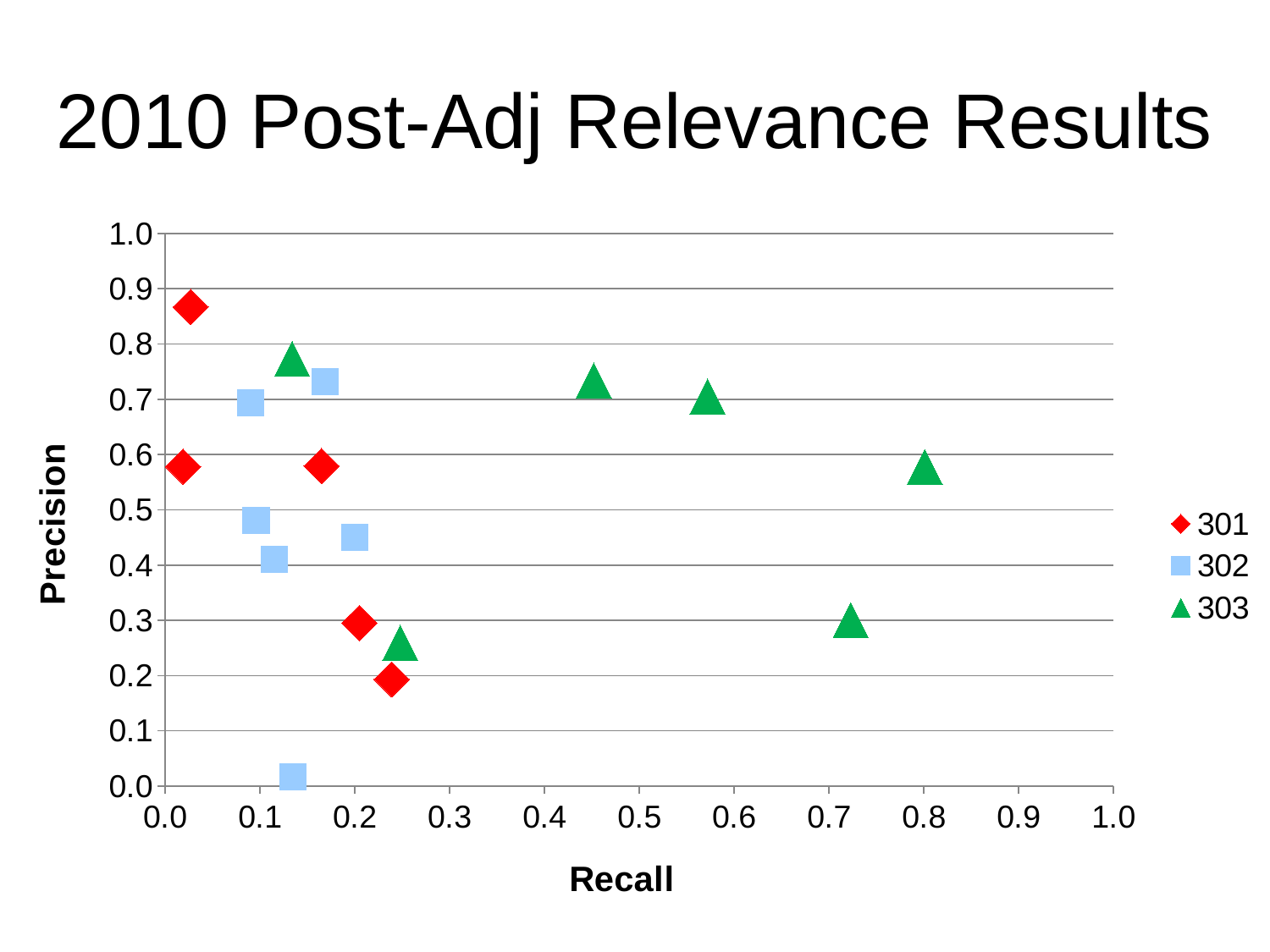
Is the recall of the rightmost series 303 point greater or less than 0.7? greater Which series contains the point with the highest precision? 301 What are the three series named in the legend? 301, 302, 303 What kind of chart is shown on the slide? Scatter chart How many series does the legend list? 3 Which series contains the point with the highest recall? 303 Is the precision of the highest series 301 point greater or less than 0.8? greater How many points are plotted for series 301 (red diamonds)? 5 How many points are plotted for series 303 (green triangles)? 6 What is the title of the chart? 2010 Post-Adj Relevance Results Which series contains the point with the lowest precision? 302 Is the precision of the lowest series 302 point greater or less than 0.1? less